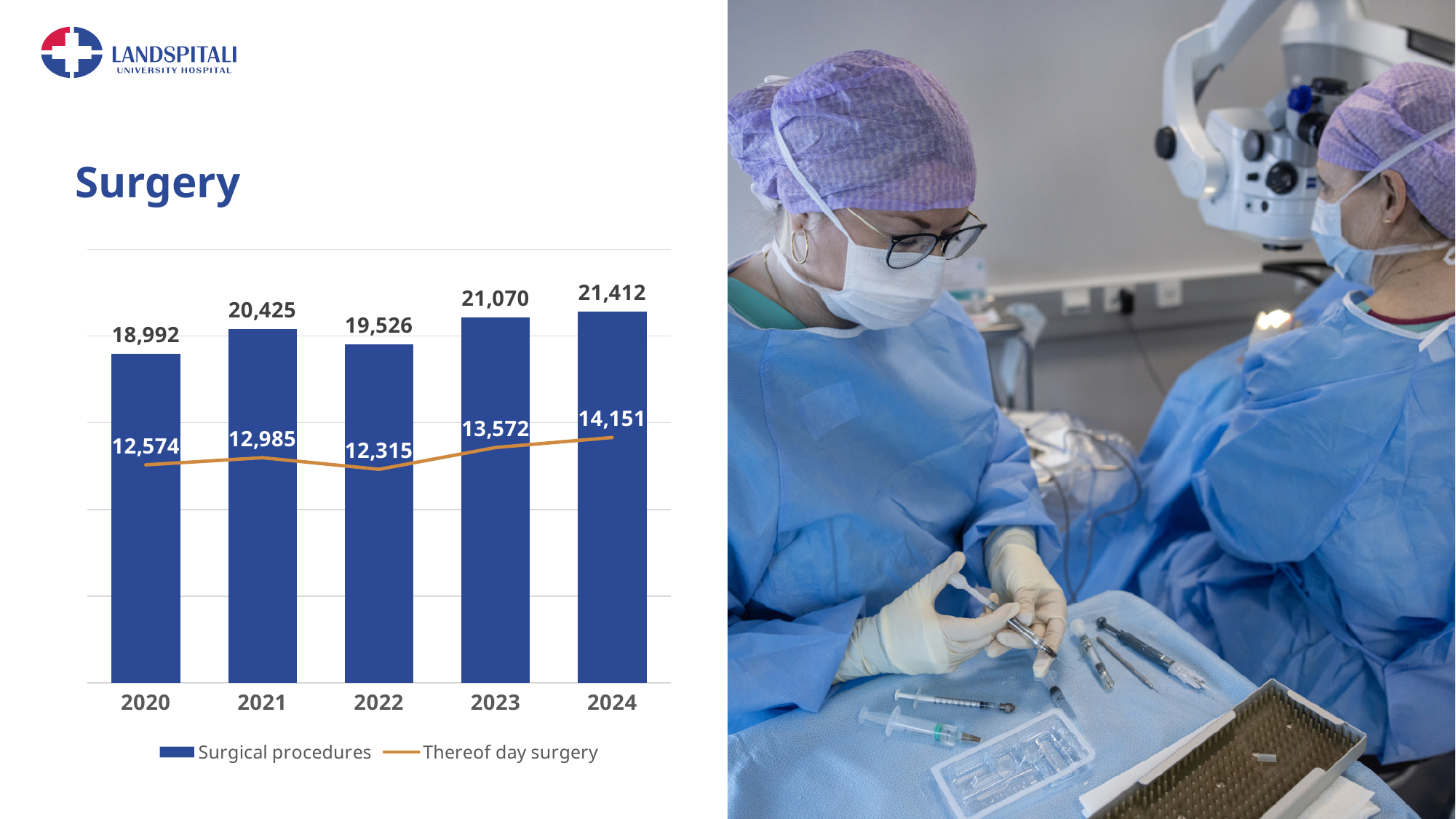
How many years are shown on the x axis of the chart? 5 Which year has the highest number of surgical procedures? 2024 Which year had more surgical procedures, 2021 or 2022? 2021 What kind of chart is used to show surgical procedures? Bar chart What is the difference between surgical procedures in 2024 and 2020? 2,420 What is the number of surgical procedures in 2020? 18,992 What is the value for 'Thereof day surgery' in 2022? 12,315 What is the title of the slide containing the chart? Surgery How many series does the legend list? 2 Which year has the lowest value for 'Thereof day surgery'? 2022 What is the number of surgical procedures in 2024? 21,412 What is the difference between surgical procedures and day surgery in 2023? 7,498